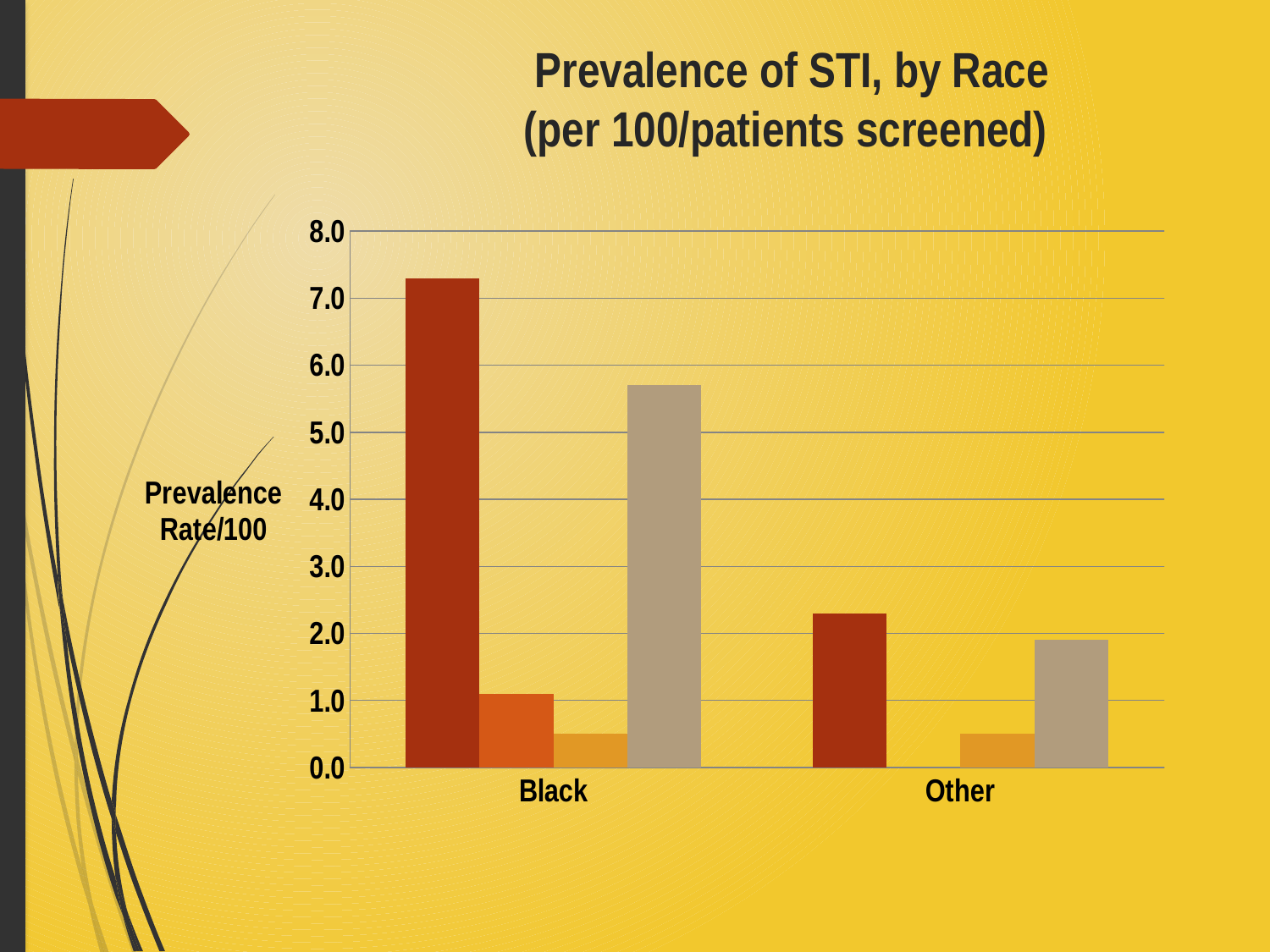
What is the title of the chart? Prevalence of STI, by Race (per 100/patients screened) Within the Black category, which is larger, the dark red bar or the tan bar? the dark red bar Which is larger, the dark red bar for Black or the dark red bar for Other? Black Is the value of the dark red bar for Black greater or less than 7.0? greater Which category contains the tallest bar in the chart? Black Is the value of the light orange bar for Black greater or less than 1.0? less What kind of chart is shown on the slide? bar chart How many race categories are shown on the x axis? 2 What is the label on the vertical axis of the chart? Prevalence Rate/100 Is the value of the dark red bar for Other greater or less than 2.0? greater